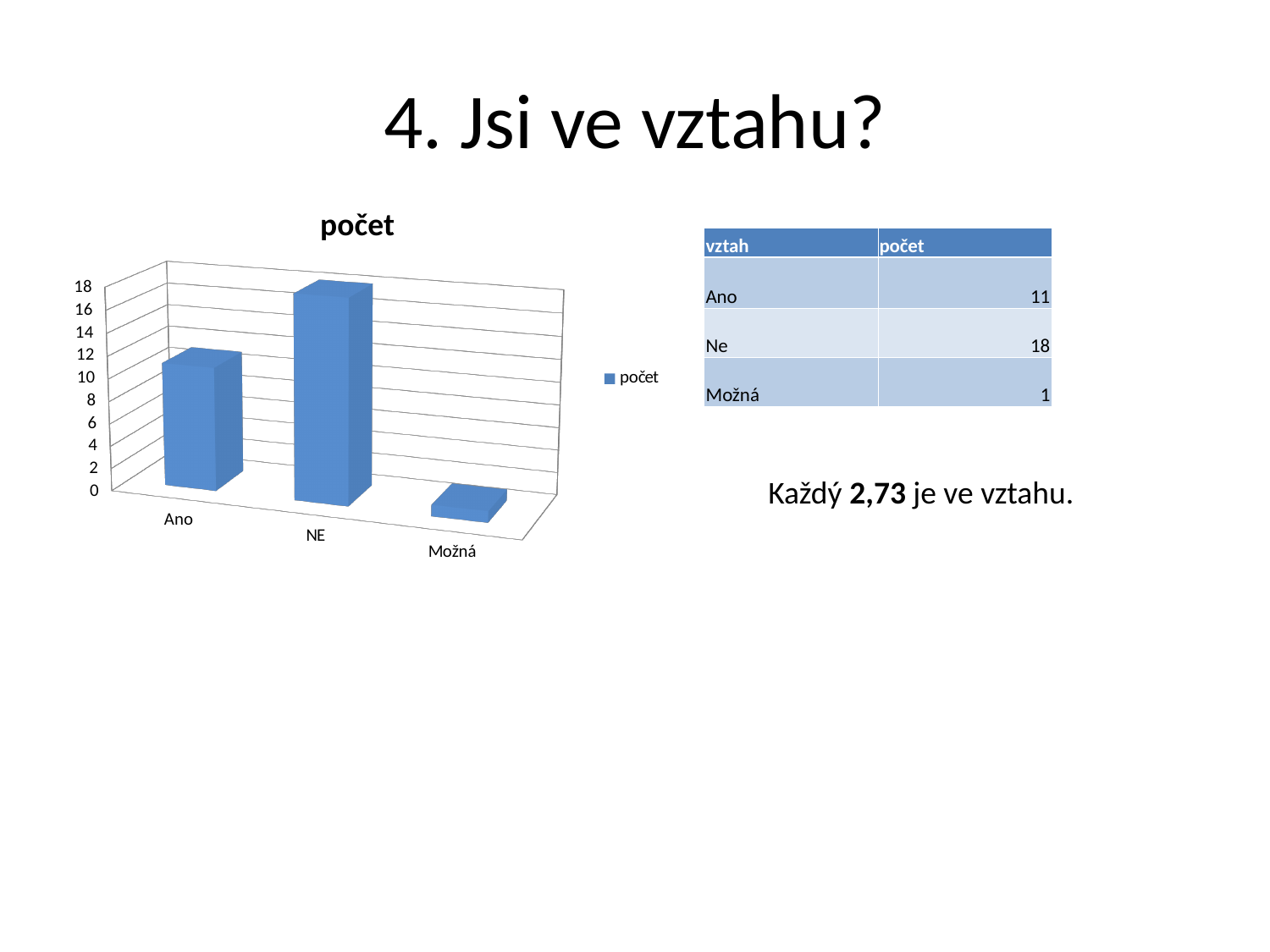
According to the table on the slide, what is the počet value for Ano? 11 Which category has the lowest value in the chart? Možná How many categories are shown on the x axis of the chart? 3 How many series does the chart legend list? 1 Which is larger, the value for Ano or the value for NE? NE What is the title of the chart? počet According to the table on the slide, what is the počet value for Možná? 1 What type of chart is shown on the slide? bar chart Which category has the highest value in the chart? NE According to the table on the slide, what is the počet value for Ne? 18 Using the values in the table, what is the difference between the počet for Ne and the počet for Ano? 7 Is the value for Ano greater or less than 10? greater